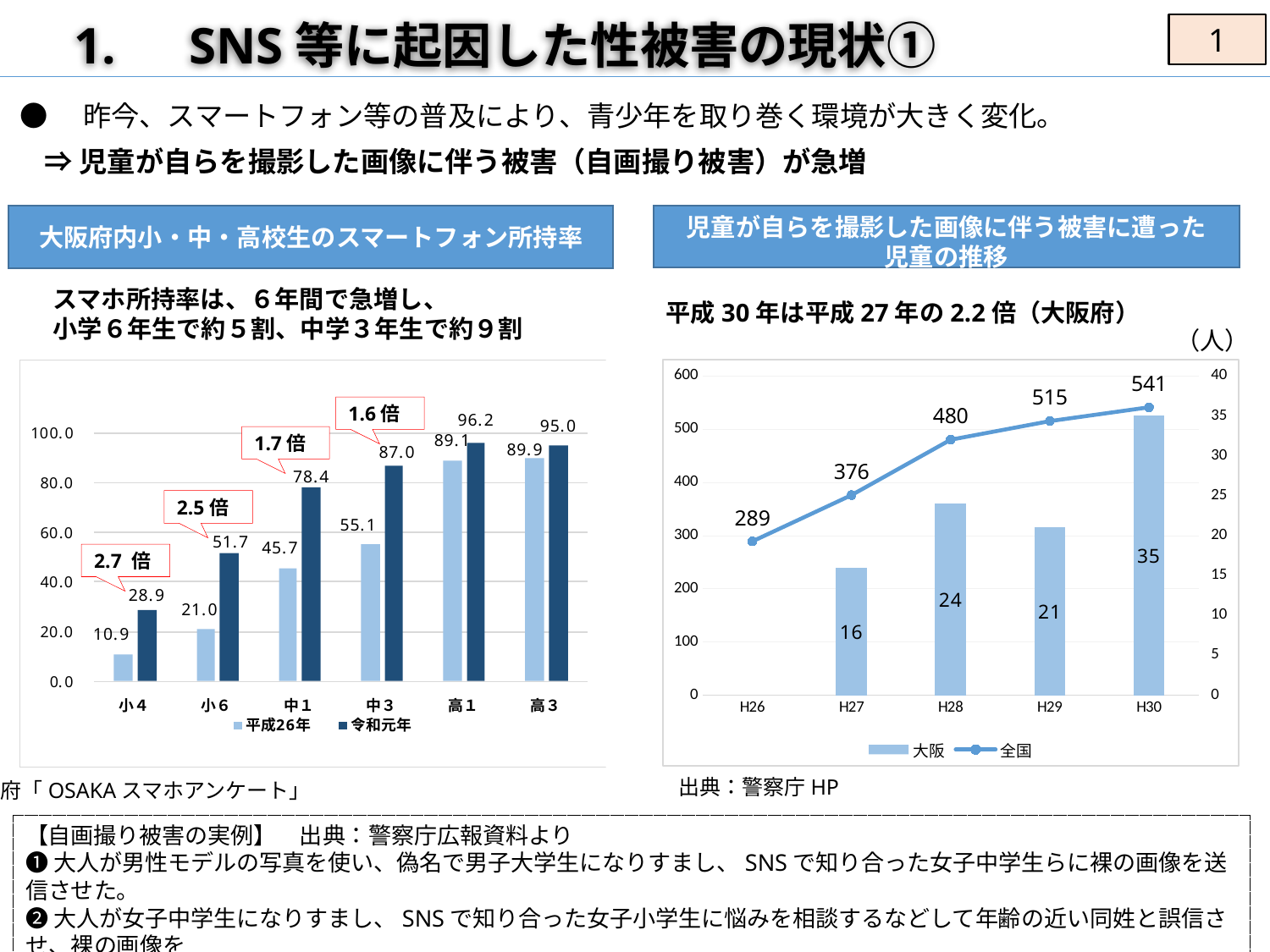
In the right chart (児童が自らを撮影した画像に伴う被害に遭った児童の推移), does the 全国 line rise or fall from H26 to H30? rise In the left chart (大阪府内小・中・高校生のスマートフォン所持率), how many categories are shown on the x axis? 6 In the left chart (大阪府内小・中・高校生のスマートフォン所持率), which category has the highest 令和元年 value? 高1 In the right chart (児童が自らを撮影した画像に伴う被害に遭った児童の推移), what is the difference between the 全国 values for H30 and H26? 252 In the left chart (大阪府内小・中・高校生のスマートフォン所持率), what is the value for 中1 in the 令和元年 series? 78.4 In the right chart (児童が自らを撮影した画像に伴う被害に遭った児童の推移), what is the 大阪 value for H30? 35 In the right chart (児童が自らを撮影した画像に伴う被害に遭った児童の推移), what is the 全国 value for H28? 480 In the right chart (児童が自らを撮影した画像に伴う被害に遭った児童の推移), which year has the lowest 大阪 value among the years with a bar? H27 In the left chart (大阪府内小・中・高校生のスマートフォン所持率), what is the value for 小4 in the 平成26年 series? 10.9 In the left chart (大阪府内小・中・高校生のスマートフォン所持率), what is the difference between the 令和元年 and 平成26年 values for 中3? 31.9 In the left chart (大阪府内小・中・高校生のスマートフォン所持率), how many series does the legend list? 2 In the left chart (大阪府内小・中・高校生のスマートフォン所持率), which is larger: the 平成26年 value for 高3 or the 平成26年 value for 高1? 高3